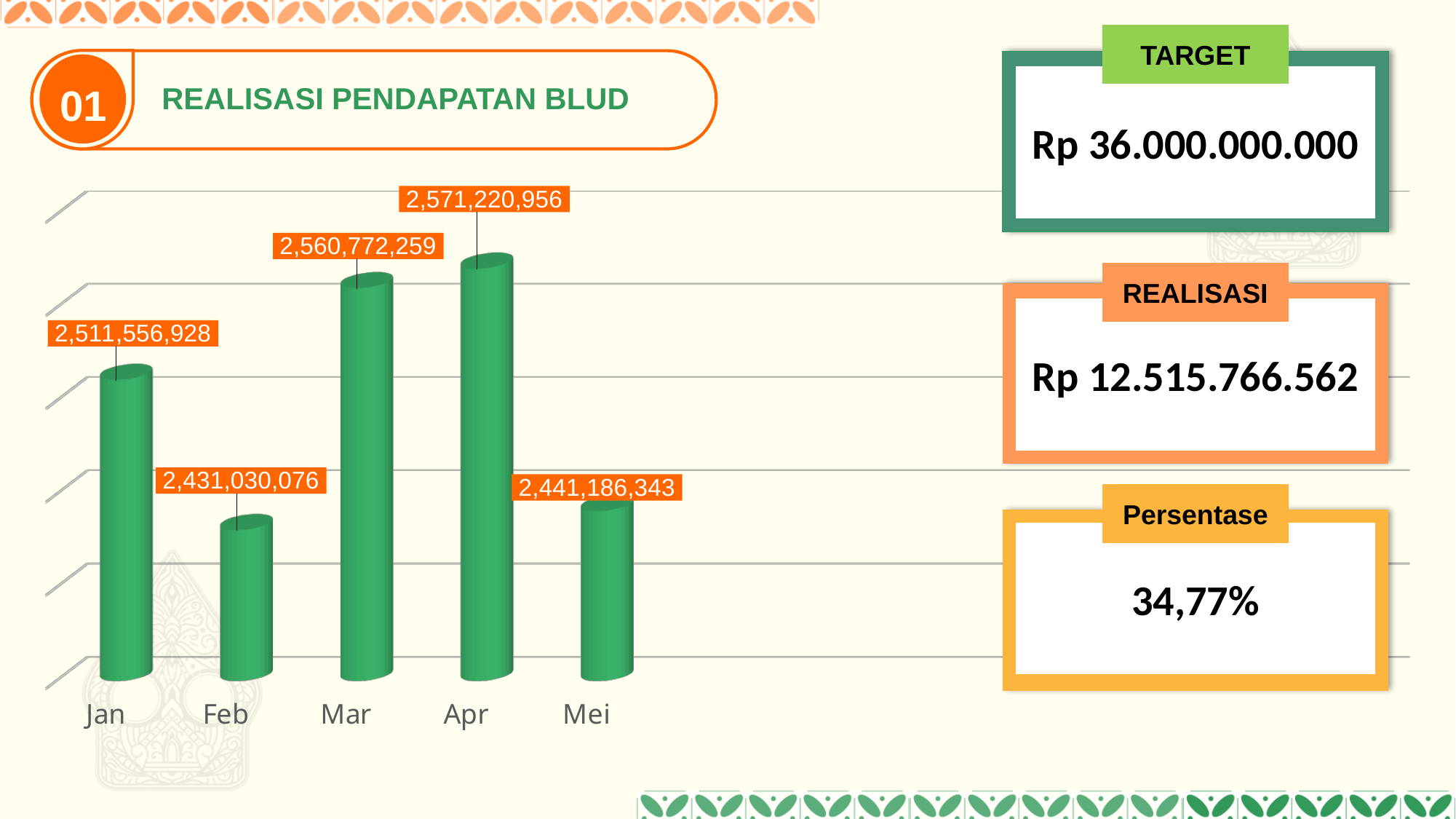
What is the value for Mar? 2,560,772,259 How many months are shown on the chart? 5 What is the value for Mei? 2,441,186,343 What kind of chart is shown on the slide? Bar chart What is the difference between the values for Jan and Feb? 80,526,852 Do the values rise or fall from Jan to Feb? Fall Which is larger, the value for Jan or the value for Mei? Jan What is the difference between the values for Apr and Mar? 10,448,697 Which month has the highest value? Apr What is the value for Jan? 2,511,556,928 Which month has the lowest value? Feb What is the value for Feb? 2,431,030,076